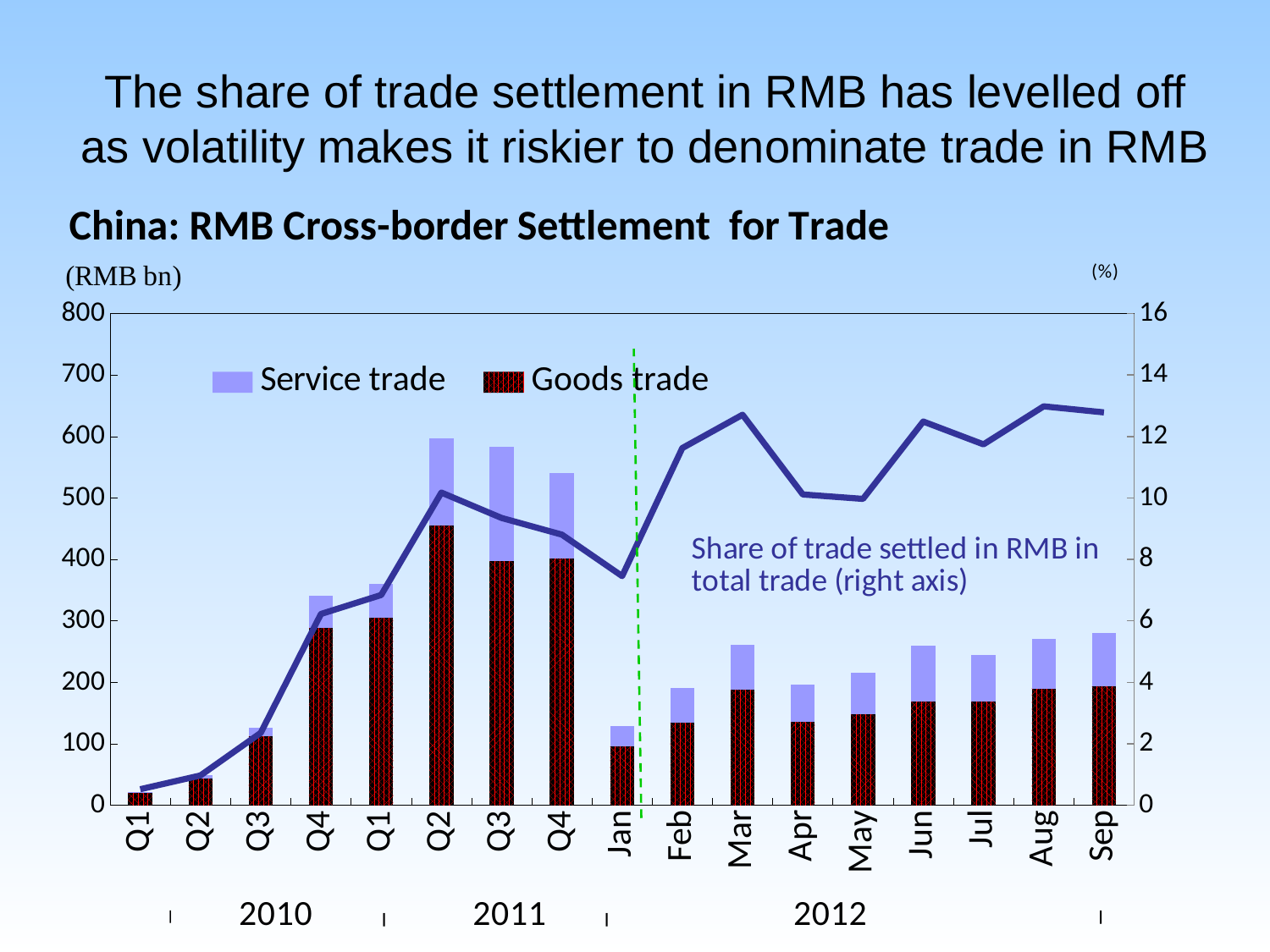
Is the Goods trade value for Mar 2012 greater or less than 200 RMB bn? less Which has the larger total bar, Q2 2011 or Q4 2011? Q2 2011 Which period has the highest total bar (Service trade plus Goods trade)? Q2 2011 Is the share of trade settled in RMB in Q1 2010 greater or less than 2%? less Is the total bar for Q2 2011 greater or less than 500 RMB bn? greater Does the share of trade settled in RMB rise or fall from Q1 2010 to Q2 2011? rise How many series does the legend list? 2 Which period has the lowest total bar? Q1 2010 What kind of chart is this? Stacked bar chart with a line How many bars (time periods) are plotted on the x axis? 17 What is the title of the chart? China: RMB Cross-border Settlement for Trade